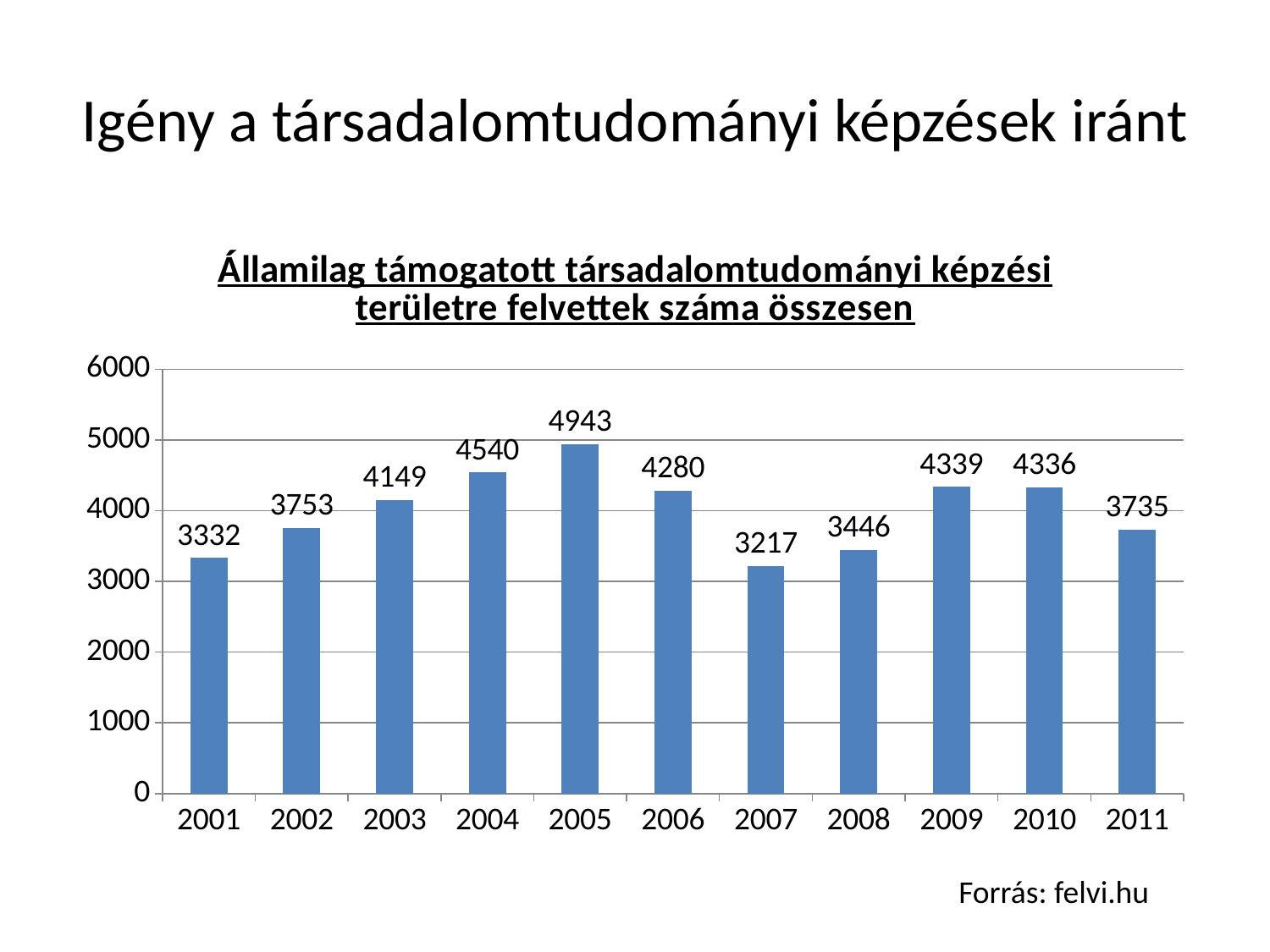
How many years are shown on the x axis? 11 What is the difference between the values for 2004 and 2003? 391 What is the value for 2007? 3217 Is the value for 2006 greater or less than 4000? greater What is the difference between the values for 2005 and 2007? 1726 Do the values rise or fall from 2001 to 2005? rise Which year has the lowest value? 2007 What is the value for 2005? 4943 What kind of chart is shown on the slide? bar chart What is the value for 2011? 3735 Which year has the highest value? 2005 Which is larger, the value for 2002 or the value for 2008? 2002